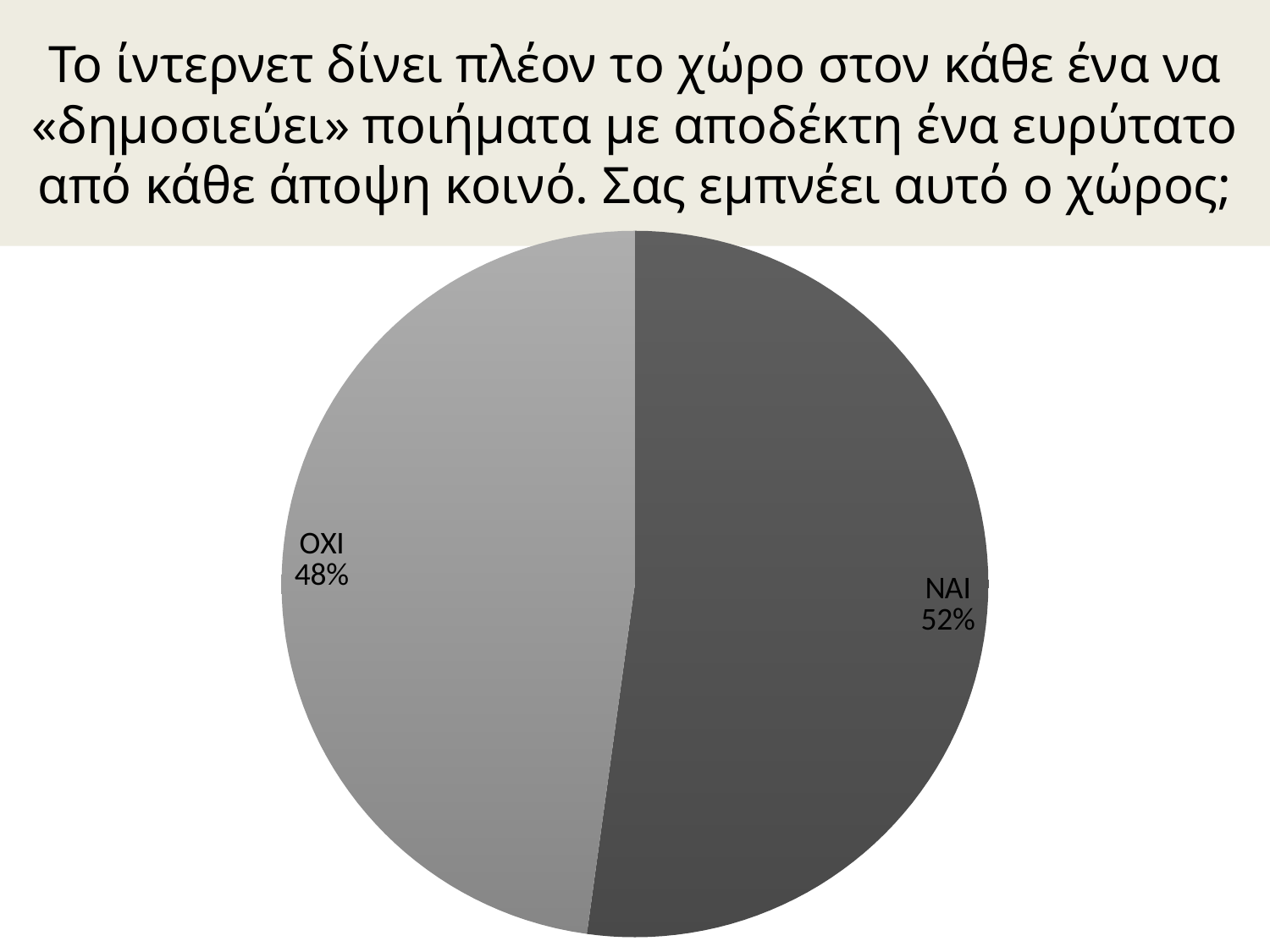
Which slice of the pie chart is the lighter grey one? ΟΧΙ Which slice of the pie chart is the darker one? ΝΑΙ What percentage of the pie is labelled ΝΑΙ? 52% Is the ΝΑΙ slice greater or less than 50% of the pie? greater What percentage of the pie is labelled ΟΧΙ? 48% Which slice is the smallest in the pie chart? ΟΧΙ What share of the pie does the ΟΧΙ slice represent? 48% Which slice is larger, ΝΑΙ or ΟΧΙ? ΝΑΙ What is the difference in percentage points between the ΝΑΙ and ΟΧΙ slices? 4 How many slices does the pie chart have? 2 What kind of chart is shown on the slide? pie chart Which slice is the largest in the pie chart? ΝΑΙ